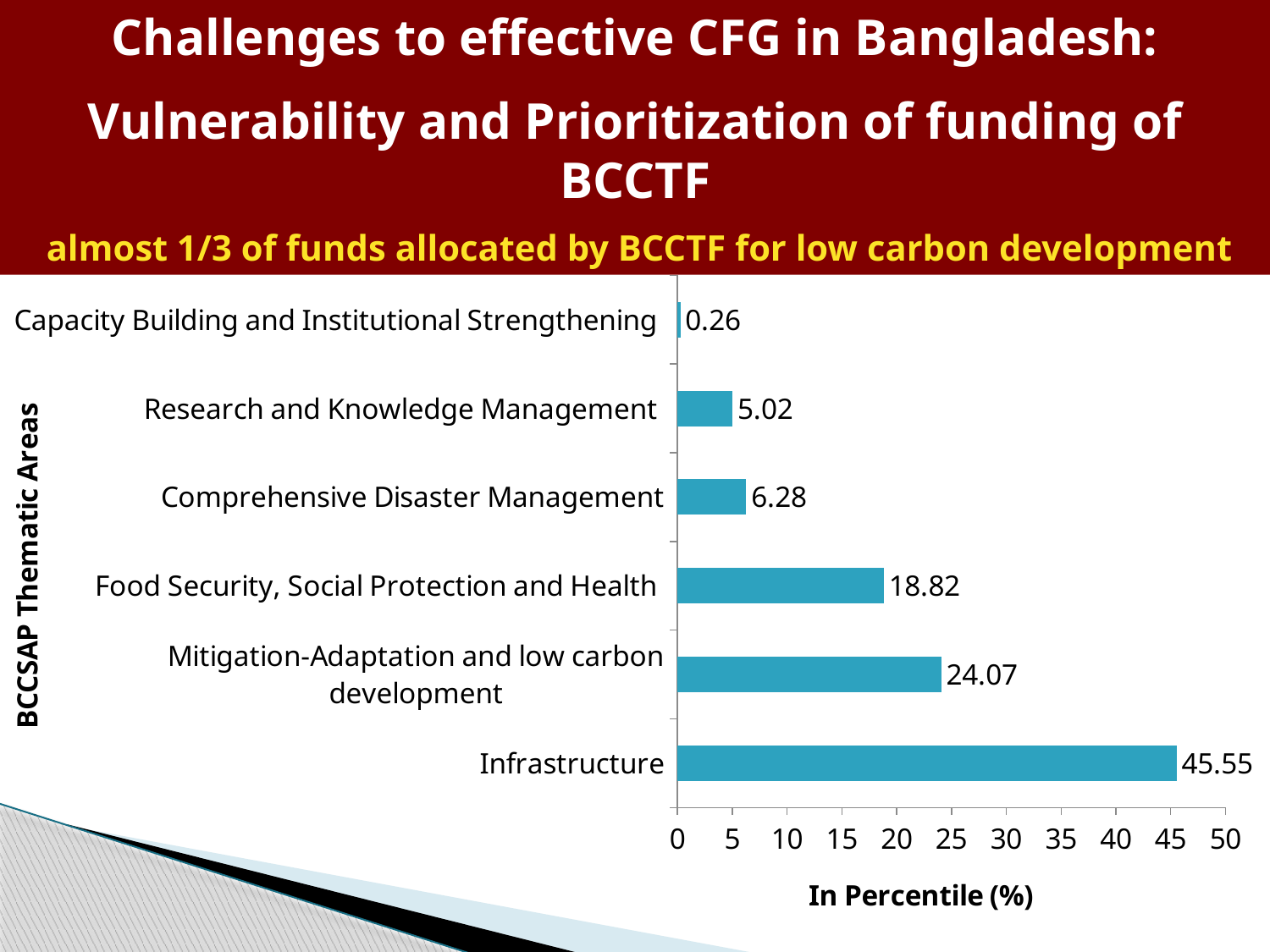
What is the value for Infrastructure? 45.55 Which is larger, the value for Comprehensive Disaster Management or Research and Knowledge Management? Comprehensive Disaster Management Is the value for Food Security, Social Protection and Health greater or less than 20? less What is the label of the horizontal axis? In Percentile (%) What is the value for Capacity Building and Institutional Strengthening? 0.26 Which thematic area has the highest value? Infrastructure What is the value for Food Security, Social Protection and Health? 18.82 What kind of chart is shown on the slide? Bar chart How many thematic areas are shown in the chart? 6 What is the difference between the values for Infrastructure and Mitigation-Adaptation and low carbon development? 21.48 What is the value for Mitigation-Adaptation and low carbon development? 24.07 Which thematic area has the lowest value? Capacity Building and Institutional Strengthening